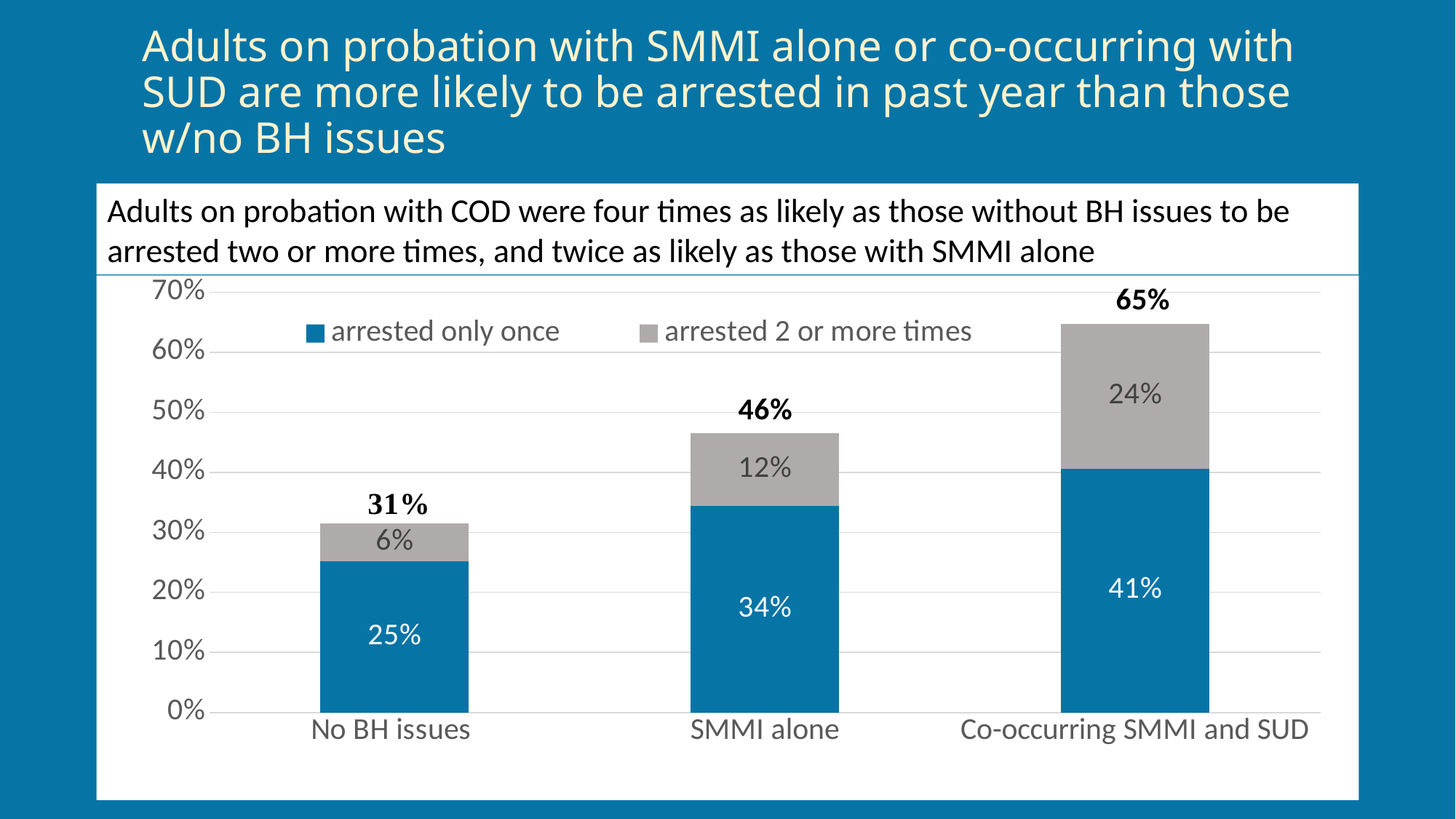
What is the value for 'arrested 2 or more times' in the SMMI alone category? 12% How many series does the legend list? 2 Which category has the lowest value for 'arrested only once'? No BH issues What is the total labelled above the stacked bar for SMMI alone? 46% What kind of chart is shown on the slide? Stacked bar chart Which is larger: the 'arrested only once' value for SMMI alone or for co-occurring SMMI and SUD? Co-occurring SMMI and SUD What percentage of adults on probation with co-occurring SMMI and SUD were arrested 2 or more times? 24% How many categories are shown on the x axis? 3 What is the difference between the 'arrested 2 or more times' values for co-occurring SMMI and SUD and for no BH issues? 18% Which colour represents 'arrested 2 or more times' in the chart? Gray What percentage of adults on probation with no BH issues were arrested only once? 25% Which category has the highest total arrest percentage? Co-occurring SMMI and SUD